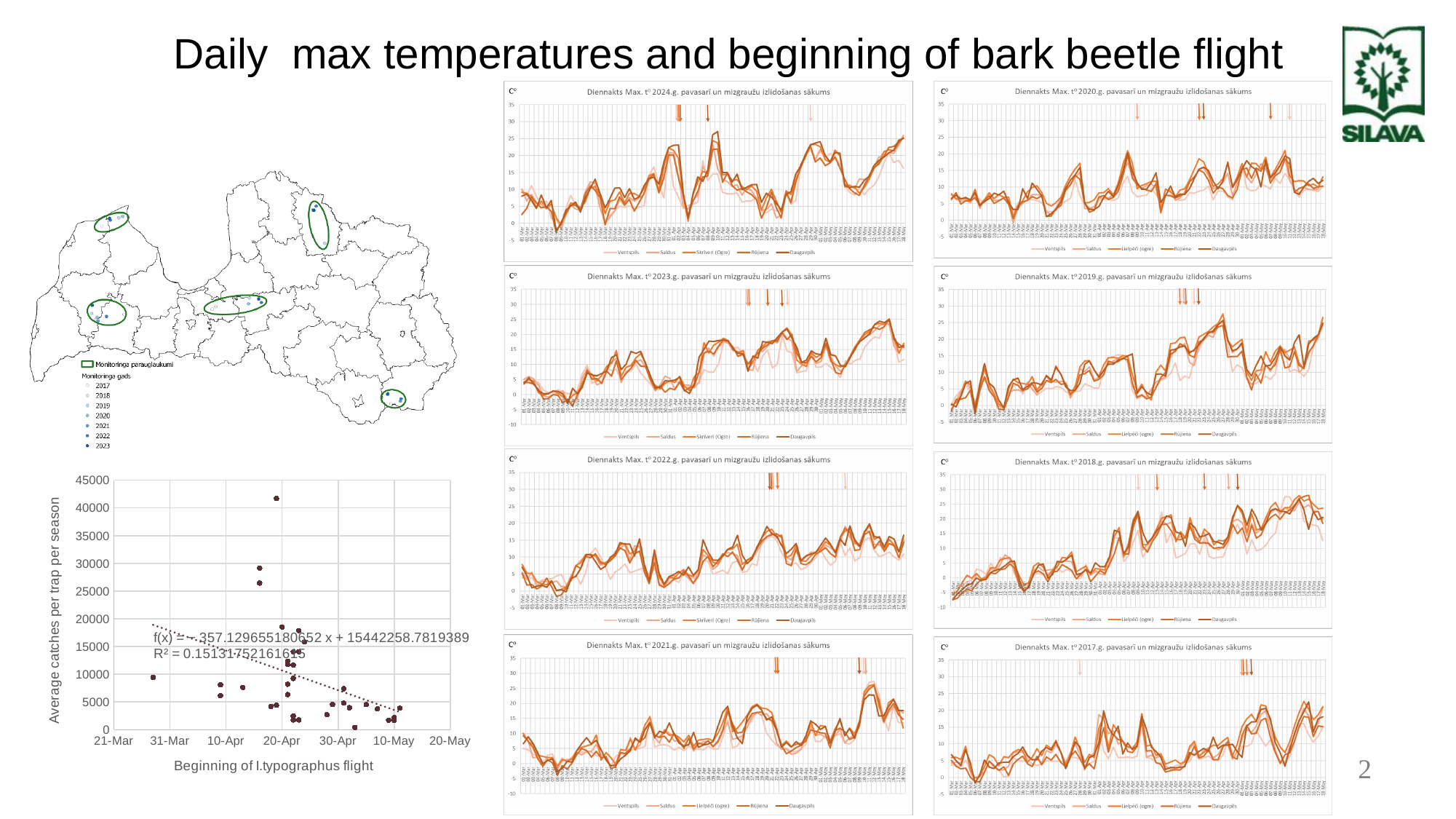
What kind of chart is the bottom-left chart with the axis 'Beginning of I.typographus flight'? scatter chart In the bottom-left scatter chart, does the fitted trendline rise or fall as the beginning of flight gets later? fall In the bottom-left scatter chart, what is the slope coefficient shown in the trendline equation f(x)? -357.129655180652 In the 'Diennakts Max. t° 2024.g.' chart, how many series does the legend list? 5 In the bottom-left scatter chart, is the highest plotted point greater or less than 40000? greater What is the highest tick value on the y axis of the bottom-left scatter chart? 45000 How many 'Diennakts Max.' temperature charts are shown on the slide? 8 Which year is shown in the title of the top-left temperature line chart? 2024 What is the x-axis label of the bottom-left scatter chart? Beginning of I.typographus flight What kind of charts are the eight 'Diennakts Max.' temperature charts on the right side of the slide? line charts What is the highest tick value on the y axis of the 'Diennakts Max. t° 2024.g.' chart? 35